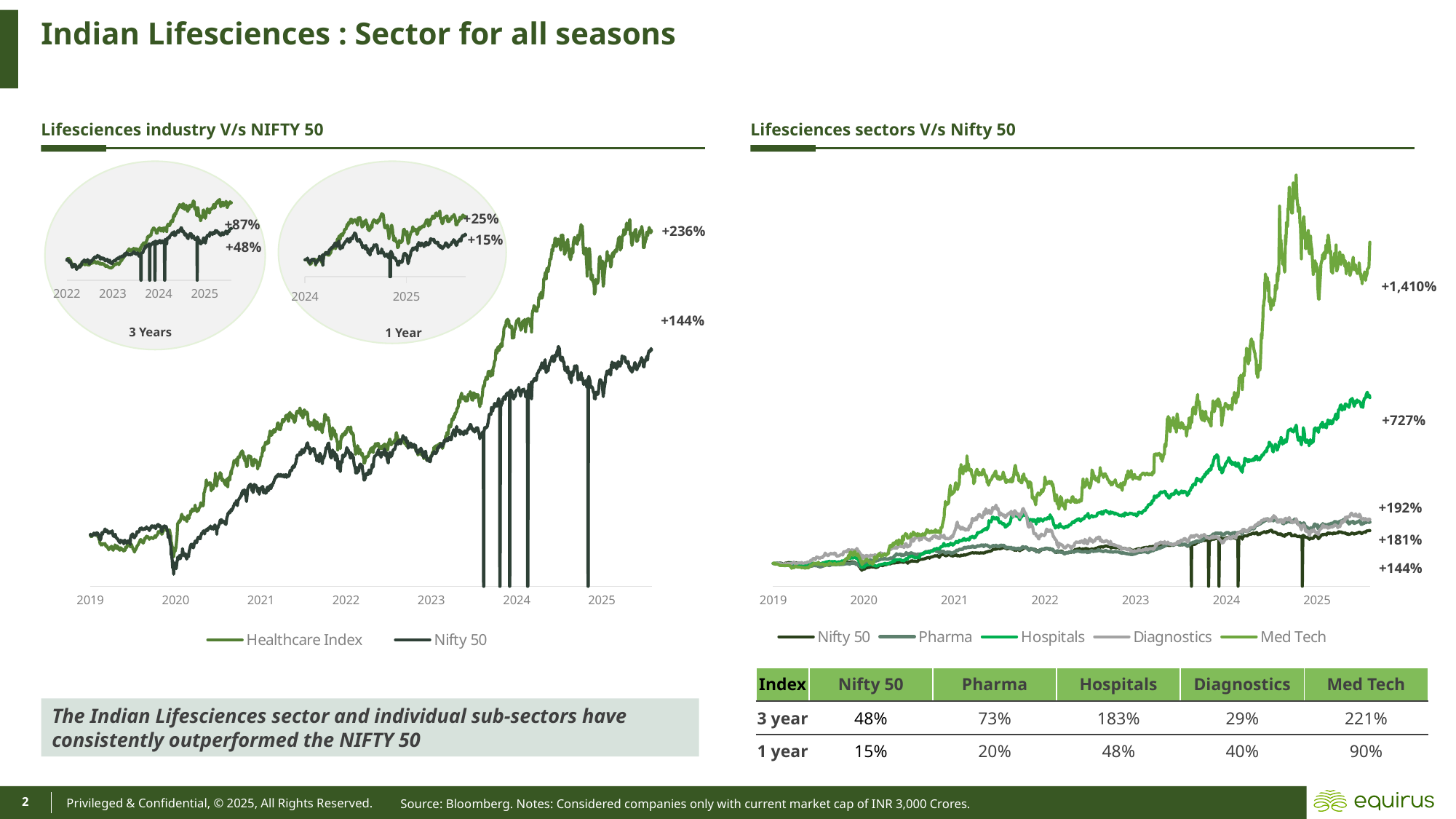
In the 'Lifesciences sectors V/s Nifty 50' chart, what return is labelled at the end of the Hospitals line? +727% In the 'Lifesciences industry V/s NIFTY 50' chart, what return is labelled at the end of the Healthcare Index line? +236% In the 'Lifesciences industry V/s NIFTY 50' chart, by how many percentage points does the Healthcare Index end label exceed the Nifty 50 end label? 92 percentage points What kind of chart is the 'Lifesciences industry V/s NIFTY 50' chart? Line chart In the 'Lifesciences industry V/s NIFTY 50' chart, what return is labelled at the end of the Nifty 50 line? +144% In the '1 Year' inset of the 'Lifesciences industry V/s NIFTY 50' chart, what return is shown for Nifty 50? +15% In the '3 Years' inset of the 'Lifesciences industry V/s NIFTY 50' chart, what return is shown for the Healthcare Index? +87% In the 'Lifesciences sectors V/s Nifty 50' chart, what return is labelled at the end of the Med Tech line? +1,410% In the 'Lifesciences sectors V/s Nifty 50' chart, which series ends with the highest return? Med Tech How many series does the legend of the 'Lifesciences industry V/s NIFTY 50' chart list? 2 How many series does the legend of the 'Lifesciences sectors V/s Nifty 50' chart list? 5 In the 'Lifesciences sectors V/s Nifty 50' chart, which ends higher, Hospitals or Med Tech? Med Tech